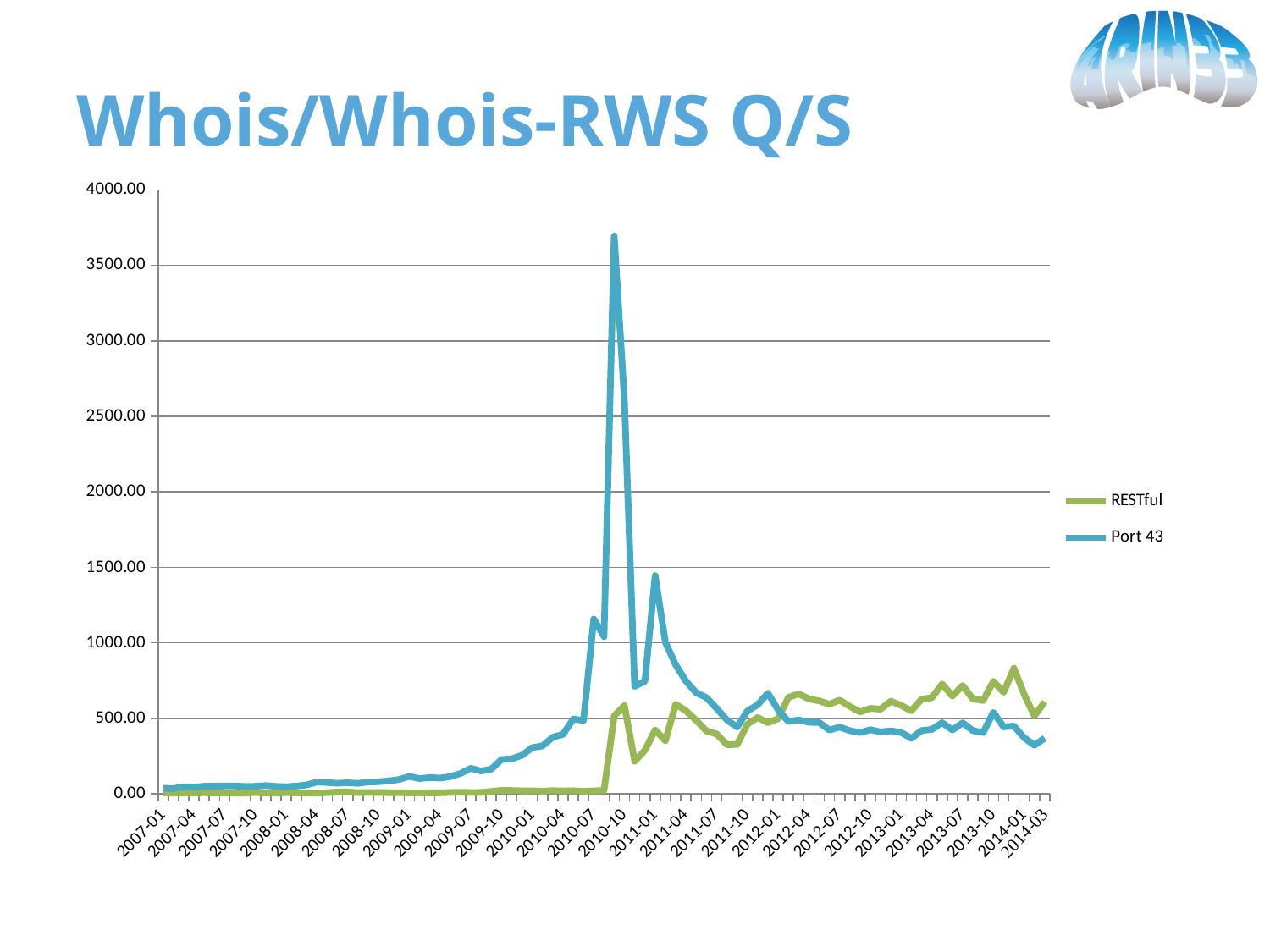
What kind of chart is shown on the slide? line chart Is the value for RESTful at 2014-01 greater or less than 500.00? greater How many series does the legend list? 2 At 2010-10, which series has the higher value, RESTful or Port 43? Port 43 What is the title of the slide containing the chart? Whois/Whois-RWS Q/S Is the value for Port 43 at 2014-03 greater or less than 500.00? less What are the two series named in the legend? RESTful and Port 43 Is the value for RESTful at 2007-01 greater or less than 500.00? less Does the Port 43 series generally rise or fall from 2007-01 to 2010-10? rise Which series reaches the highest value anywhere on the chart? Port 43 At 2014-03, which series has the higher value, RESTful or Port 43? RESTful